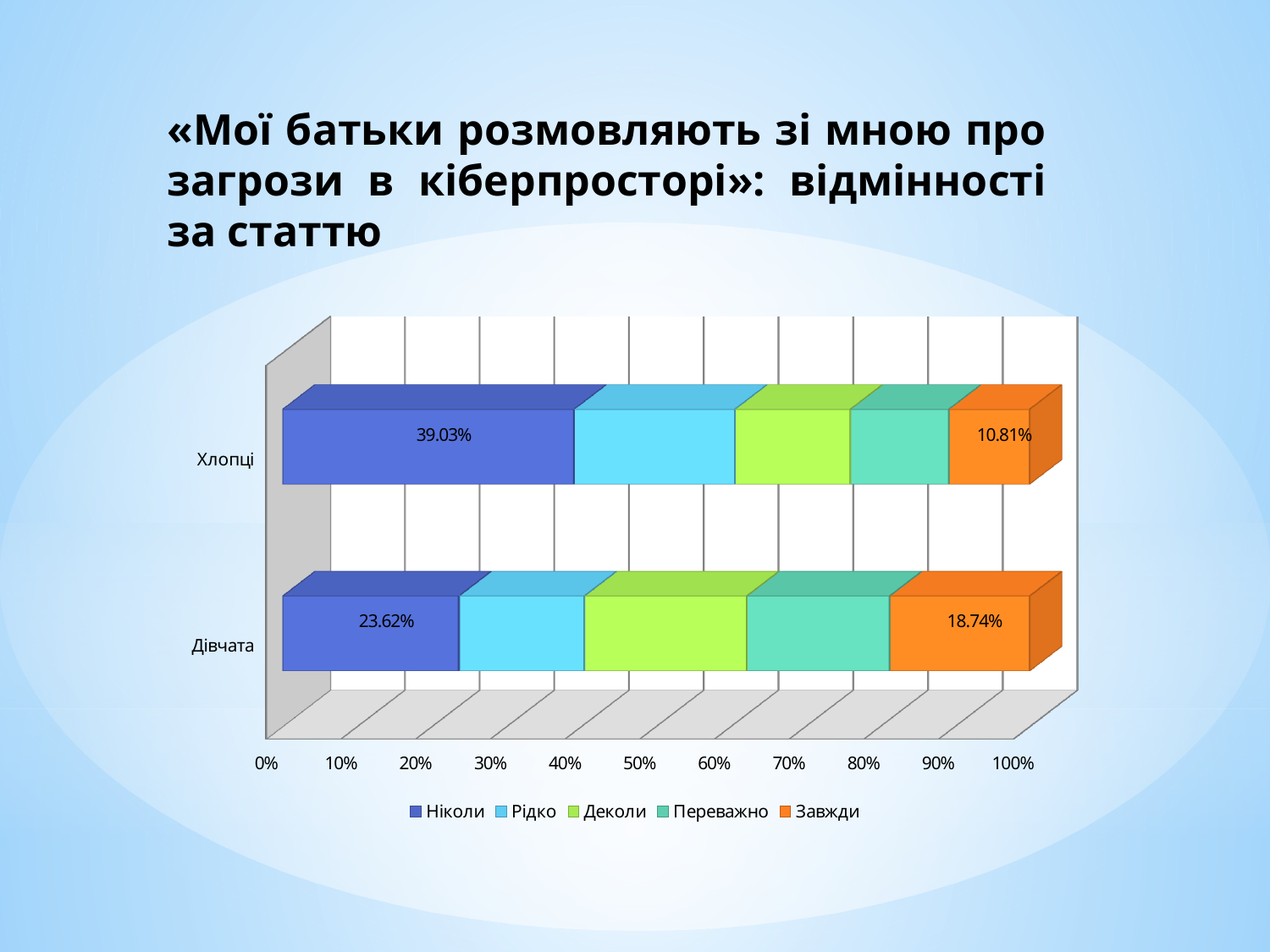
How many categories (groups) are shown on the chart? 2 How many series does the legend list? 5 What is the difference between the Завжди values for Дівчата and Хлопці? 7.93% What colour represents the Завжди series in the legend? Orange Which group has the larger Ніколи value, Хлопці or Дівчата? Хлопці What kind of chart is shown on the slide? Stacked bar chart What is the difference between the Ніколи values for Хлопці and Дівчата? 15.41% What is the value of Ніколи for Дівчата? 23.62% What is the value of Завжди for Дівчата? 18.74% Which group has the larger Завжди value, Хлопці or Дівчата? Дівчата What is the value of Ніколи for Хлопці? 39.03% What is the value of Завжди for Хлопці? 10.81%